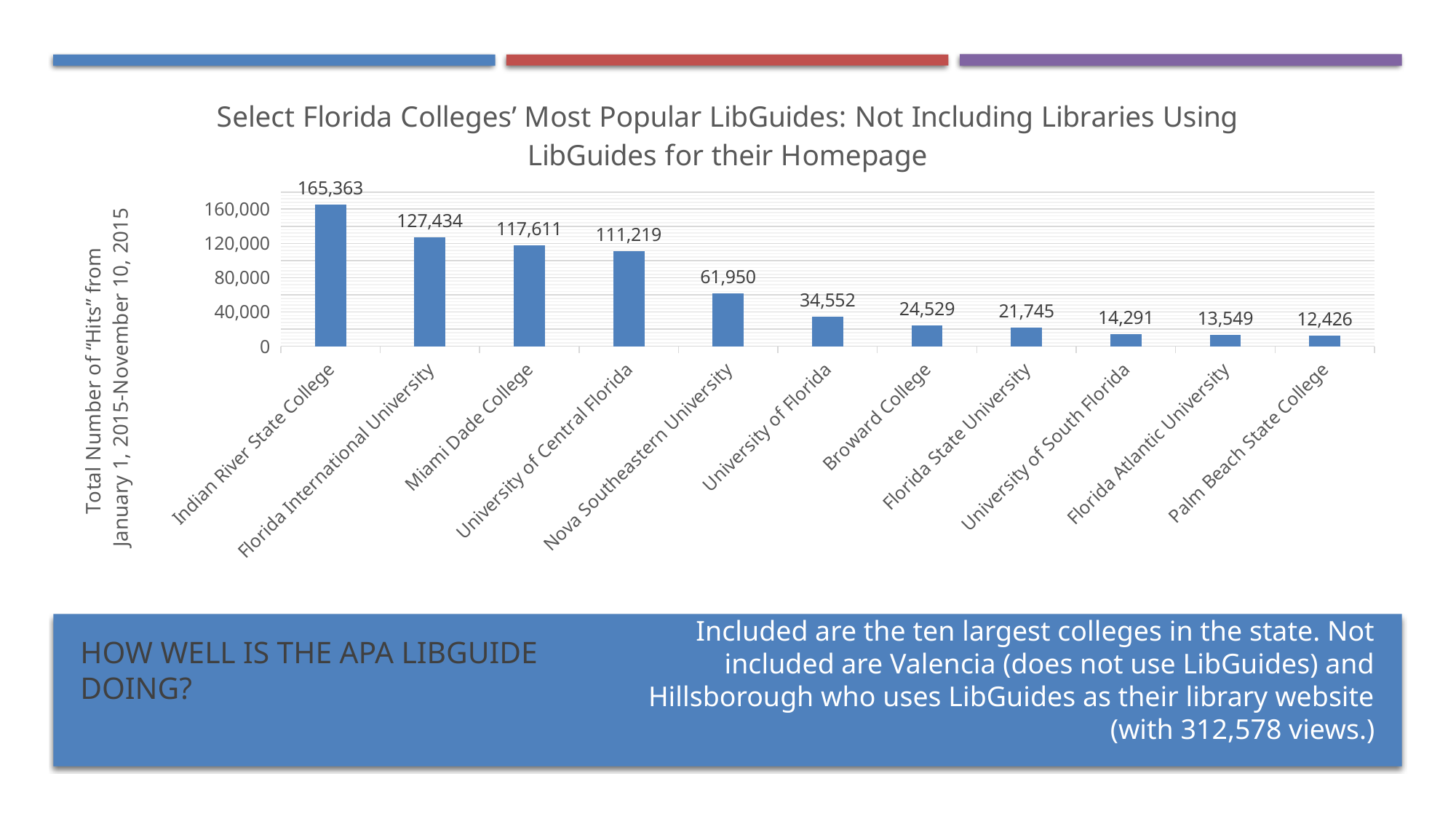
How many colleges are shown in the chart? 11 What is the value for Indian River State College? 165,363 What kind of chart is shown on the slide? bar chart What is the value for Florida State University? 21,745 Do the values rise or fall from left to right along the x axis? fall Which college has the lowest number of hits? Palm Beach State College What is the difference between the values for Nova Southeastern University and University of Florida? 27,398 Which college has the highest number of hits? Indian River State College What is the value for Nova Southeastern University? 61,950 Is the value for University of Florida greater or less than 40,000? less What is the difference between the values for Indian River State College and Florida International University? 37,929 Which is larger, the value for Miami Dade College or the value for University of Central Florida? Miami Dade College